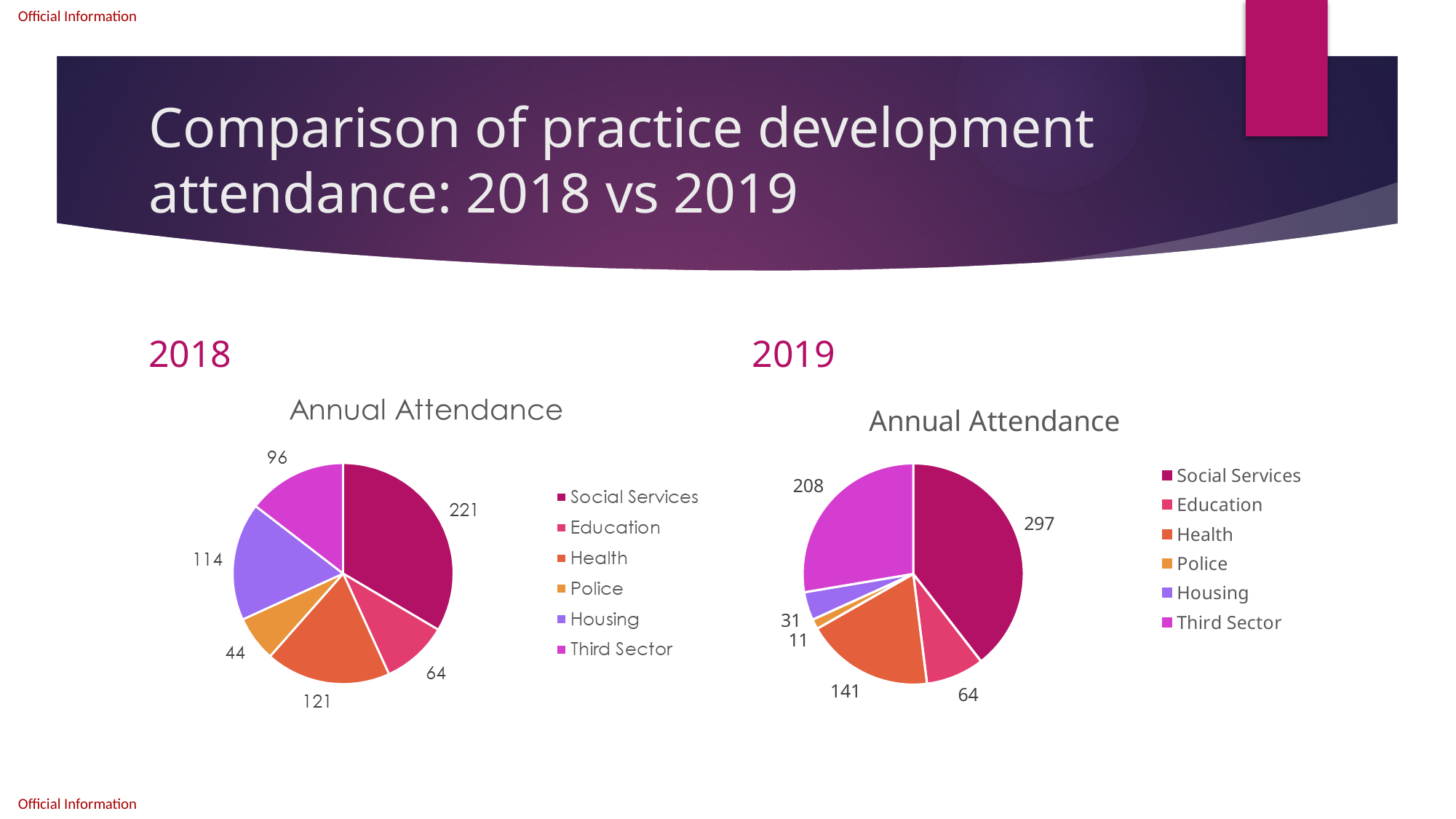
What is the total of all slices in the 2018 Annual Attendance pie chart? 660 What type of chart is used for the 2018 Annual Attendance? Pie chart In the 2018 Annual Attendance pie chart, which is larger, Health or Housing? Health In the 2019 Annual Attendance pie chart, what is the value for Police? 11 In the 2018 Annual Attendance pie chart, what is the value for Housing? 114 In the 2018 Annual Attendance pie chart, what is the value for Social Services? 221 In the 2019 Annual Attendance pie chart, what is the difference between Social Services and Health? 156 What is the title of the pie chart under the 2019 heading? Annual Attendance In the 2018 Annual Attendance pie chart, which category has the largest slice? Social Services How many categories does the 2019 Annual Attendance pie chart show? 6 In the 2019 Annual Attendance pie chart, which category has the smallest slice? Police In the 2019 Annual Attendance pie chart, what is the value for Third Sector? 208